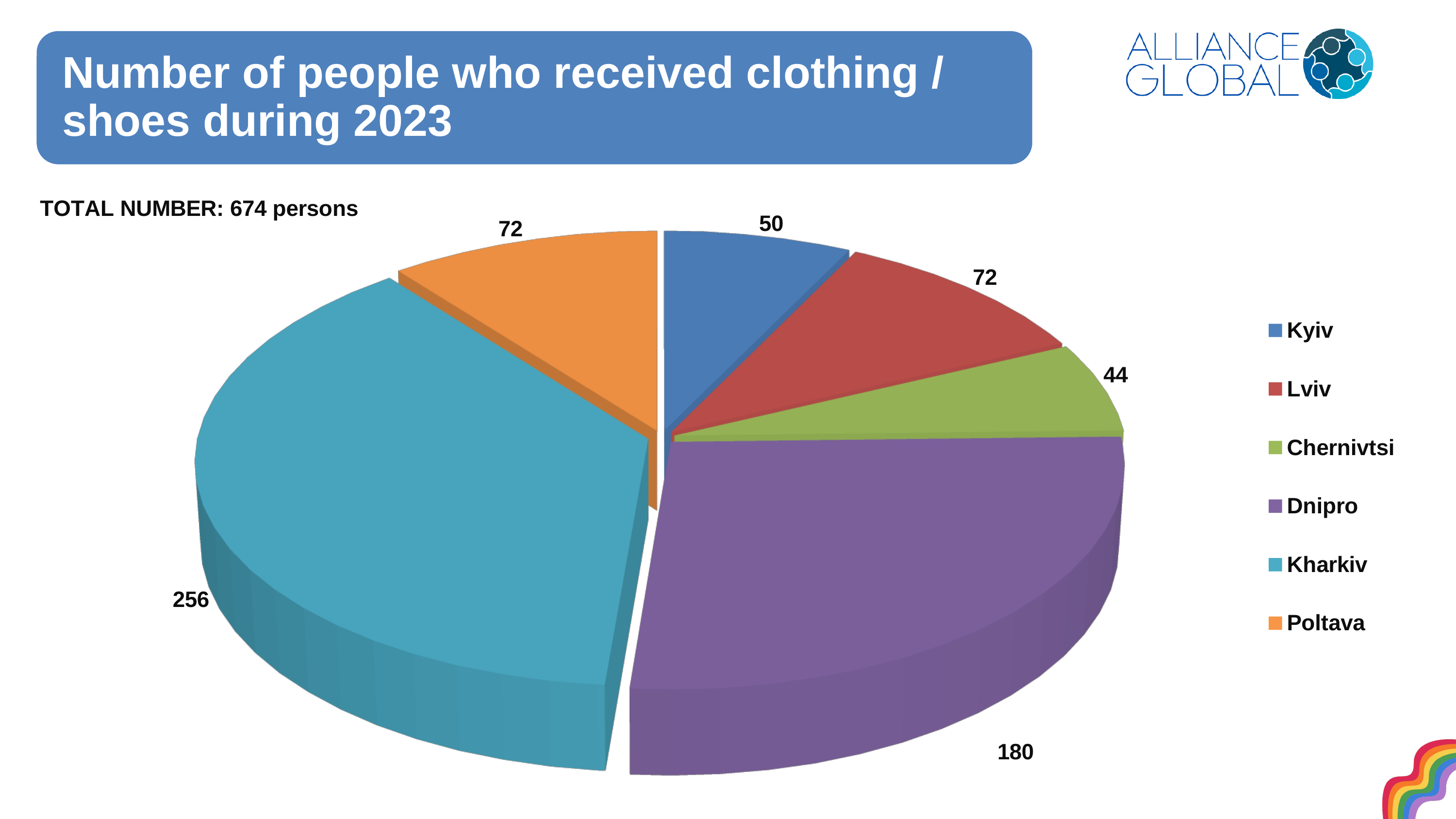
What is the total number of persons stated on the slide? 674 persons Which colour represents Poltava in the pie chart? Orange Which is larger, the value for Lviv or the value for Kyiv? Lviv What is the value for Dnipro in the pie chart? 180 Which city has the largest slice of the pie chart? Kharkiv How many cities are shown in the pie chart? 6 How many people in Kharkiv received clothing / shoes during 2023? 256 Which city has the smallest slice of the pie chart? Chernivtsi What is the difference between the values for Kharkiv and Dnipro? 76 What type of chart is shown on the slide? Pie chart What is the value for Chernivtsi in the pie chart? 44 What is the value for Kyiv in the pie chart? 50